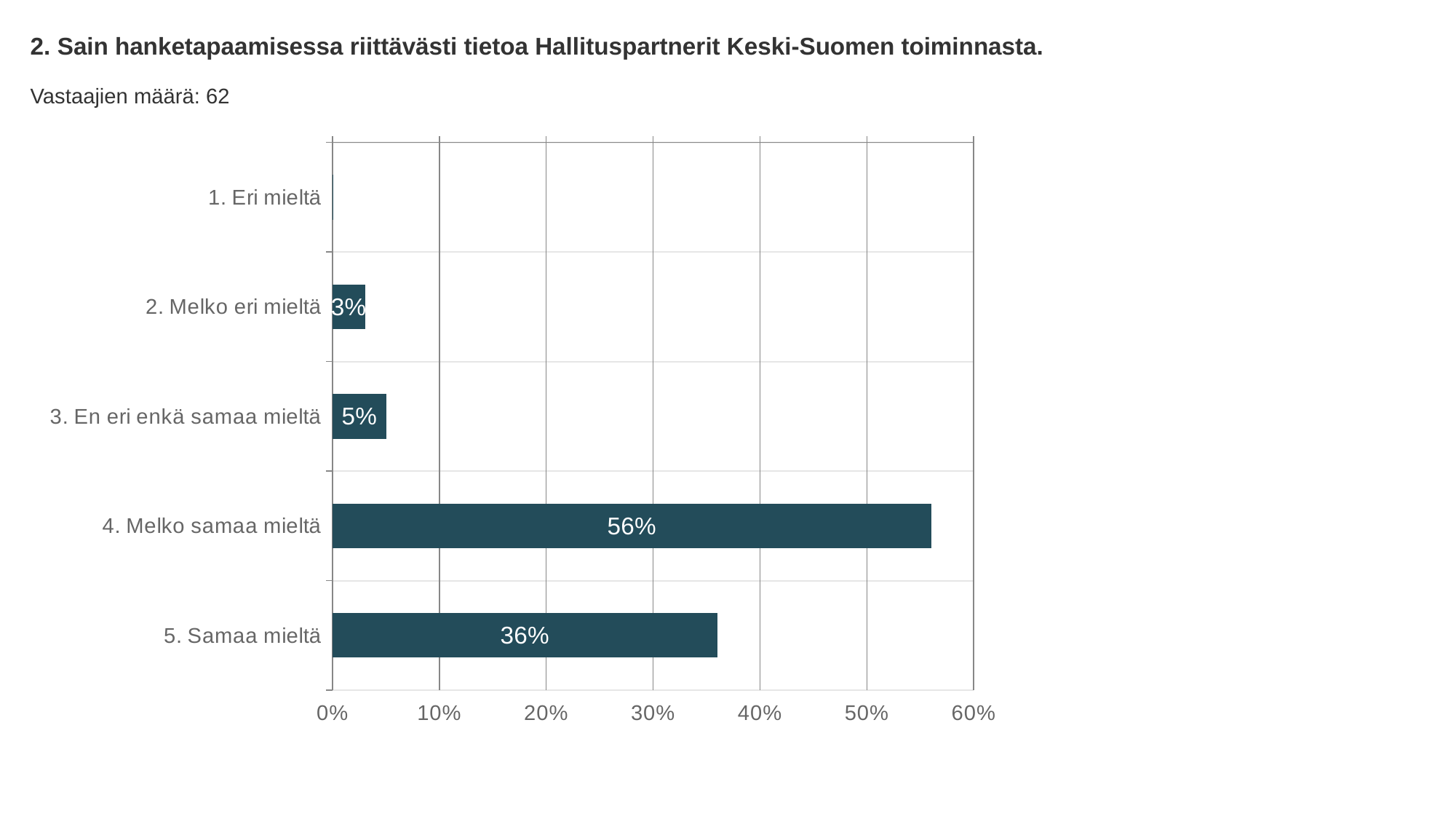
What is the value for "5. Samaa mieltä"? 36% Is the value for "4. Melko samaa mieltä" greater or less than 50%? greater What is the value for "3. En eri enkä samaa mieltä"? 5% Which is larger, the value for "3. En eri enkä samaa mieltä" or "2. Melko eri mieltä"? 3. En eri enkä samaa mieltä How many categories are shown on the chart? 5 How many respondents (Vastaajien määrä) are reported on the slide? 62 What is the difference between the values for "4. Melko samaa mieltä" and "5. Samaa mieltä"? 20% What kind of chart is shown on the slide? bar chart Which category has the lowest value? 1. Eri mieltä What is the value for "4. Melko samaa mieltä"? 56% What is the value for "2. Melko eri mieltä"? 3% Which category has the highest value? 4. Melko samaa mieltä